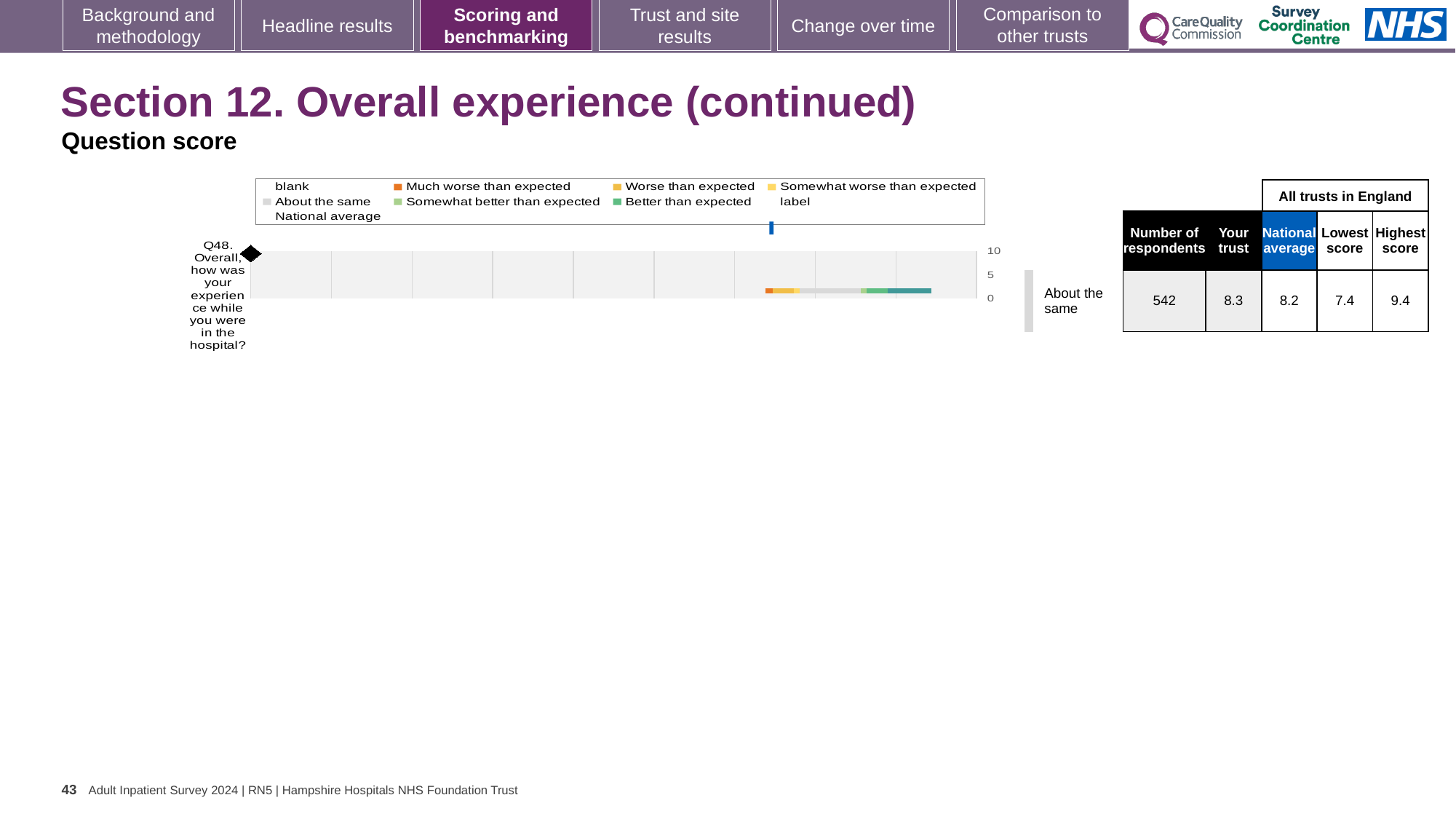
How many respondents answered Q48? 542 What is the 'Your trust' score for Q48, overall experience while in the hospital? 8.3 What kind of chart is used to show Q48 on this slide? bar chart How many survey questions are plotted in the chart? 1 What is the lowest score among all trusts in England for Q48? 7.4 Which benchmark category is the trust placed in for Q48? About the same What is the difference between the highest score and the lowest score for Q48? 2.0 What is the highest score among all trusts in England for Q48? 9.4 Which is higher for Q48, the 'Your trust' score or the national average? Your trust What is the national average score for Q48? 8.2 What colour does the legend use for 'Much worse than expected'? orange By how much does the 'Your trust' score exceed the national average for Q48? 0.1